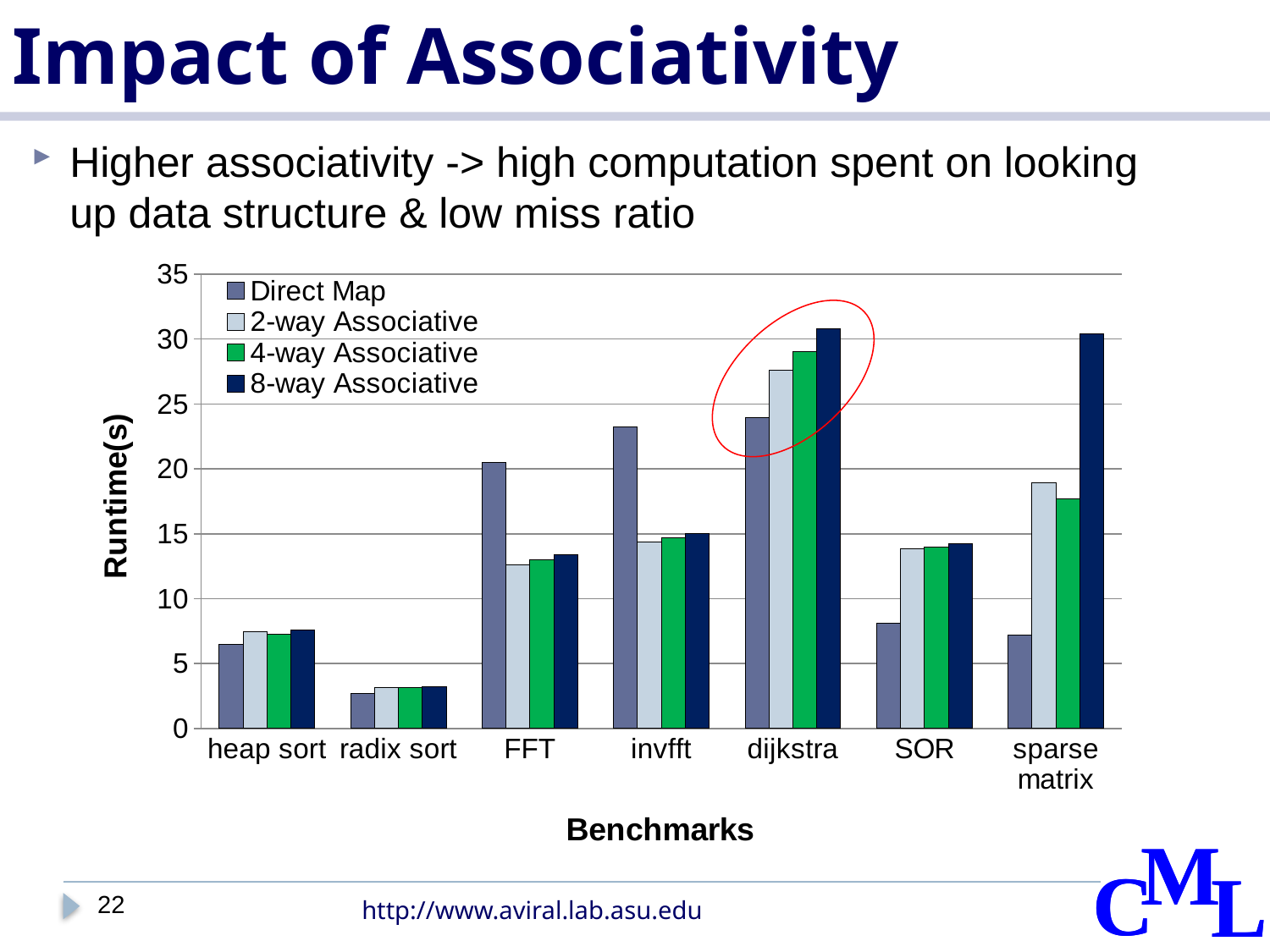
Is the Direct Map runtime for invfft greater or less than 20? greater For sparse matrix, which is larger: the 4-way Associative runtime or the 8-way Associative runtime? 8-way Associative What kind of chart is shown on the slide? bar chart For dijkstra, does runtime rise or fall as associativity increases from Direct Map to 8-way? rise For FFT, which is larger: the Direct Map runtime or the 2-way Associative runtime? Direct Map Which benchmark has the lowest Direct Map runtime? radix sort Is the 2-way Associative runtime for SOR greater or less than 15? less What is the label of the y axis? Runtime(s) How many benchmarks are shown on the x axis? 7 Is the 8-way Associative runtime for dijkstra greater or less than 25? greater How many series does the legend list? 4 Which benchmark has the highest 4-way Associative runtime? dijkstra